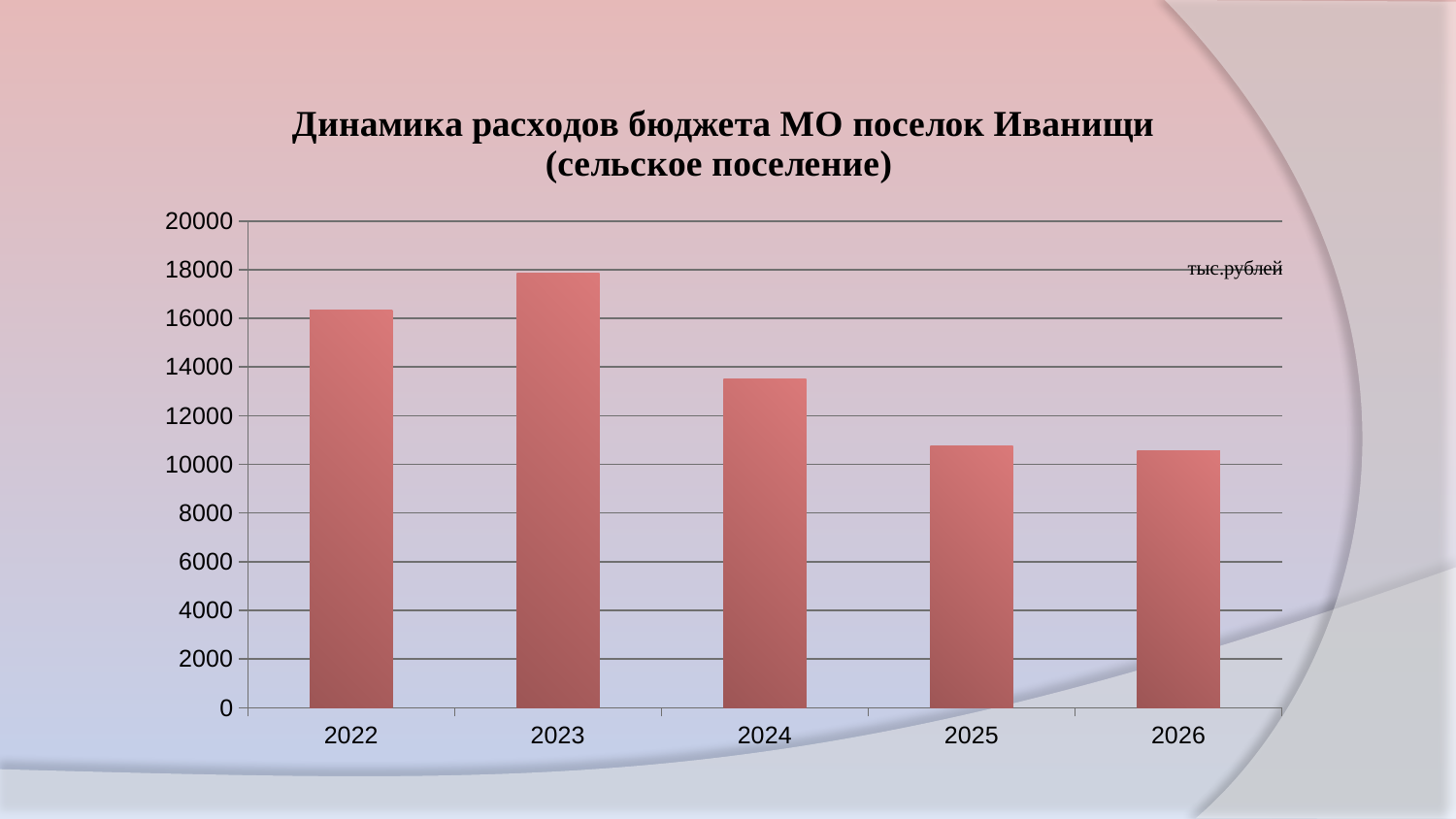
Is the value for 2024 greater or less than 14000? less Is the value for 2026 greater or less than 12000? less Is the value for 2024 greater or less than 12000? greater What unit of measurement is indicated on the chart? тыс.рублей What kind of chart is shown on the slide? bar chart From 2023 to 2026, do the values rise or fall? fall How many years are shown on the x axis of the chart? 5 Which is larger, the value for 2022 or the value for 2024? 2022 Which year has the highest budget expenditure in the chart? 2023